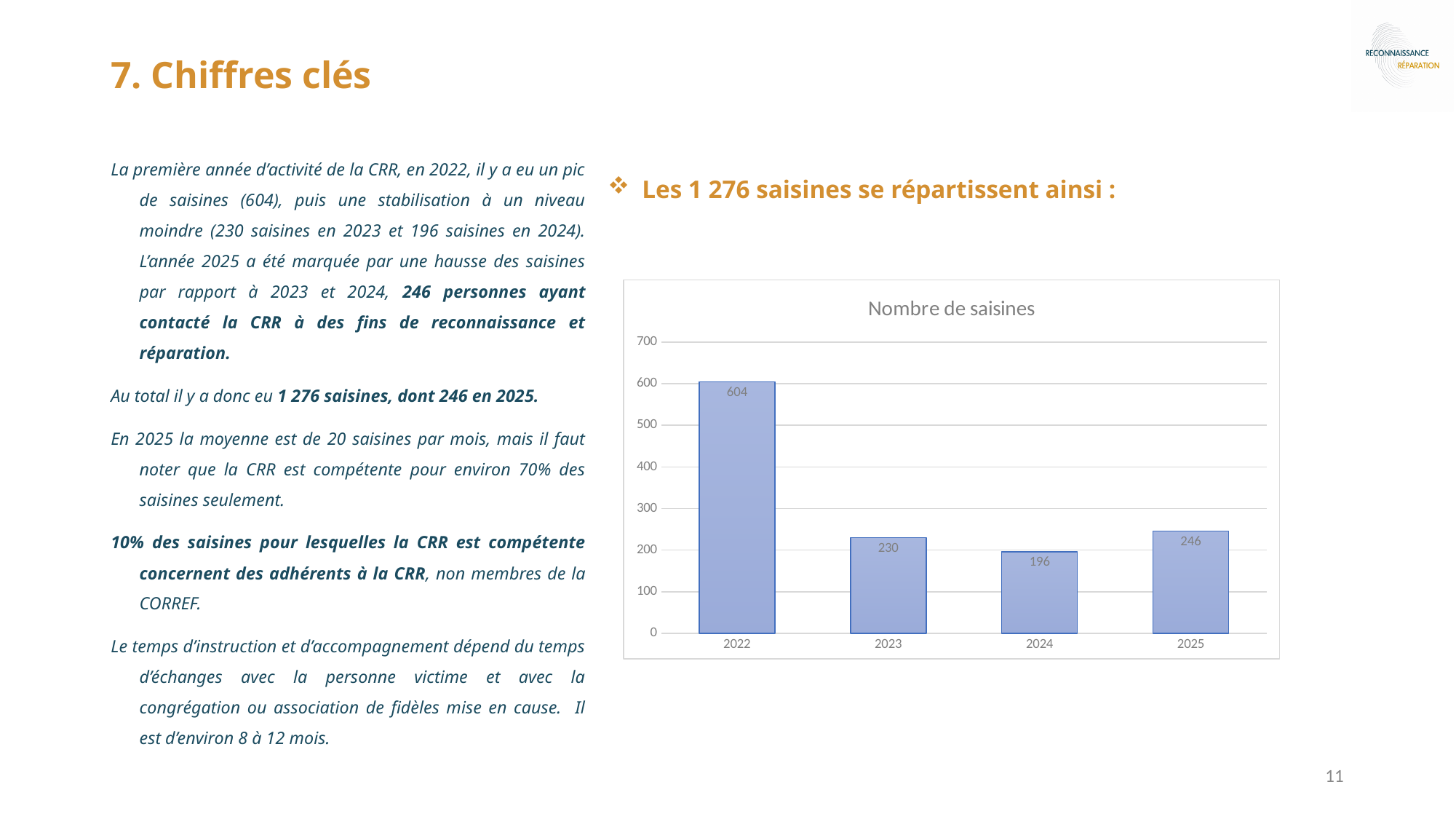
What is the difference between the values for 2025 and 2024 in the chart? 50 What is the value for 2022 in the 'Nombre de saisines' chart? 604 Which year has the lowest number of saisines in the chart? 2024 Which year has the highest number of saisines in the chart? 2022 How many years (categories) are shown in the 'Nombre de saisines' chart? 4 What is the value for 2025 in the 'Nombre de saisines' chart? 246 What is the value for 2024 in the 'Nombre de saisines' chart? 196 Is the value for 2022 in the chart greater or less than 500? greater What kind of chart is used to show 'Nombre de saisines'? Bar chart Which is larger in the chart, the value for 2023 or the value for 2025? 2025 What is the value for 2023 in the 'Nombre de saisines' chart? 230 What is the difference between the values for 2022 and 2023 in the chart? 374